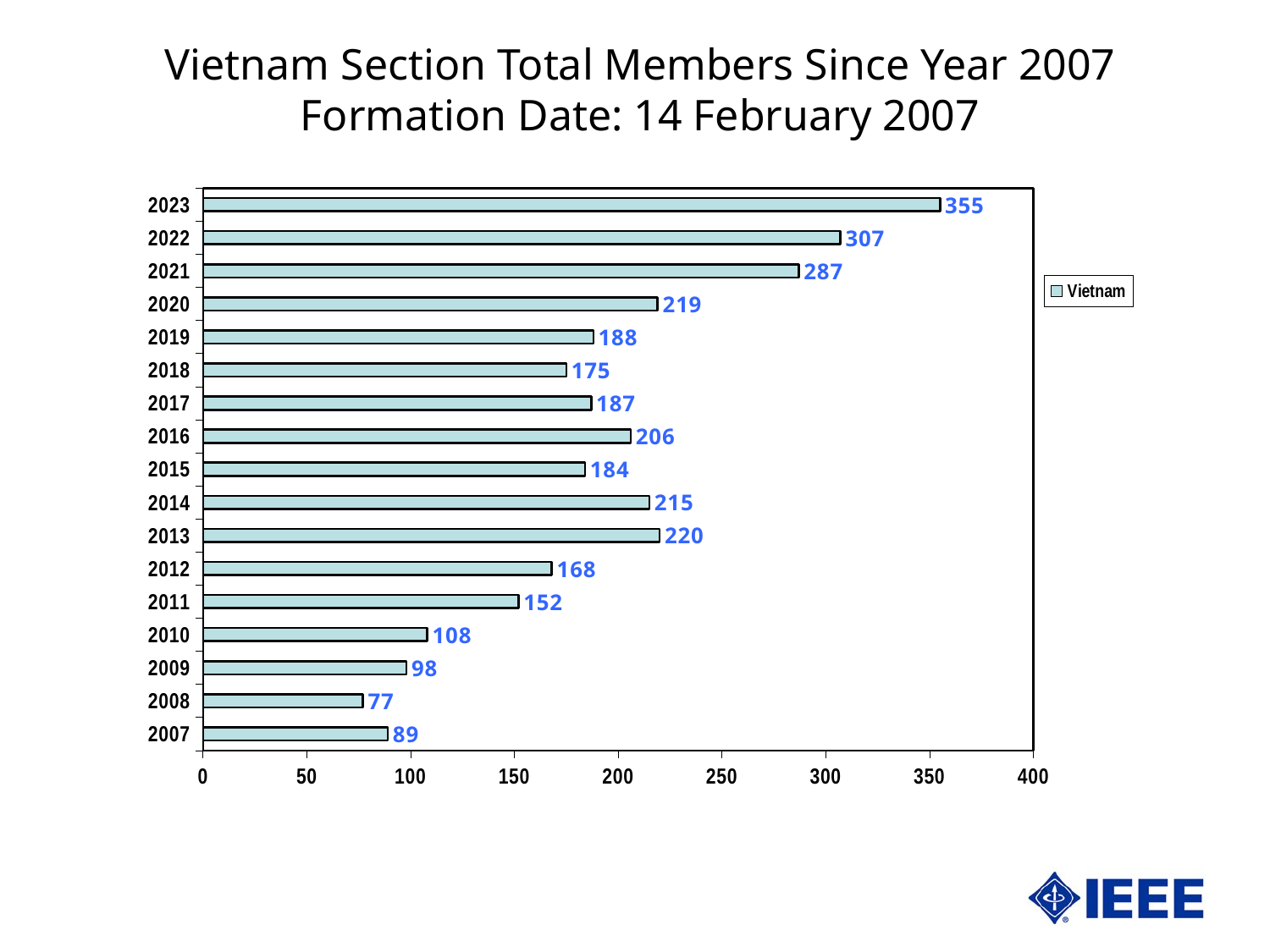
How many years are shown on the chart? 17 What is the value for 2023? 355 Which year has the highest value? 2023 How many series does the legend list? 1 What is the value for 2008? 77 What is the name of the series in the legend? Vietnam Which year has the lowest value? 2008 Which is larger, the value for 2013 or the value for 2014? 2013 What is the value for 2016? 206 Is the value for 2021 greater or less than 250? greater What kind of chart is shown on the slide? bar chart What is the difference between the values for 2023 and 2022? 48